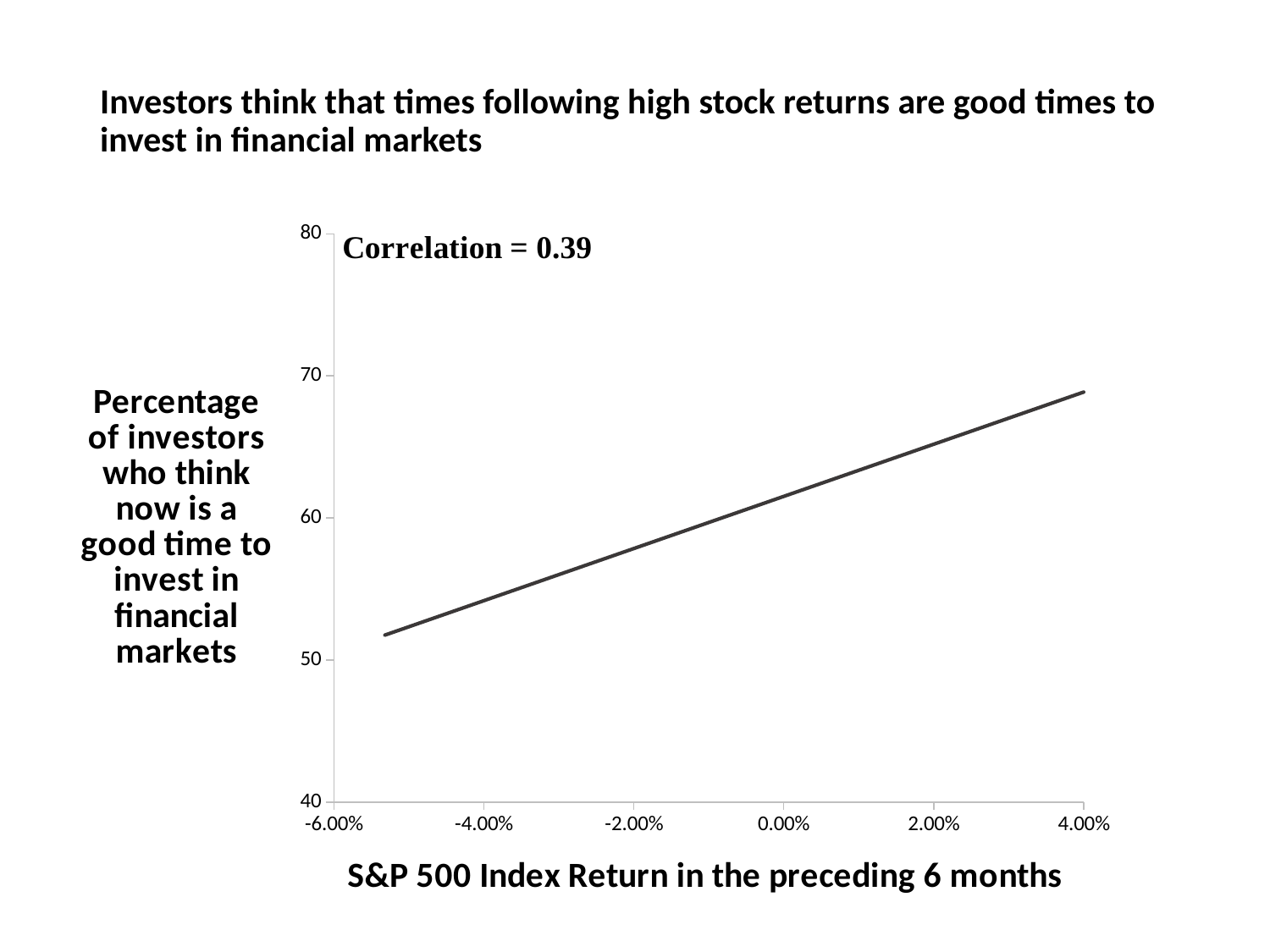
What kind of chart is shown on the slide? line chart Is the value of the line at an S&P 500 return of 2.00% greater or less than 60? greater Which has the higher value on the line: an S&P 500 return of -4.00% or 2.00%? 2.00% Is the value of the line at an S&P 500 return of -4.00% greater or less than 60? less What is the title of the x axis of the chart? S&P 500 Index Return in the preceding 6 months What correlation value is printed on the chart? 0.39 Is the value of the line at an S&P 500 return of 4.00% greater or less than 60? greater Does the line rise or fall as the S&P 500 Index Return in the preceding 6 months increases? rise